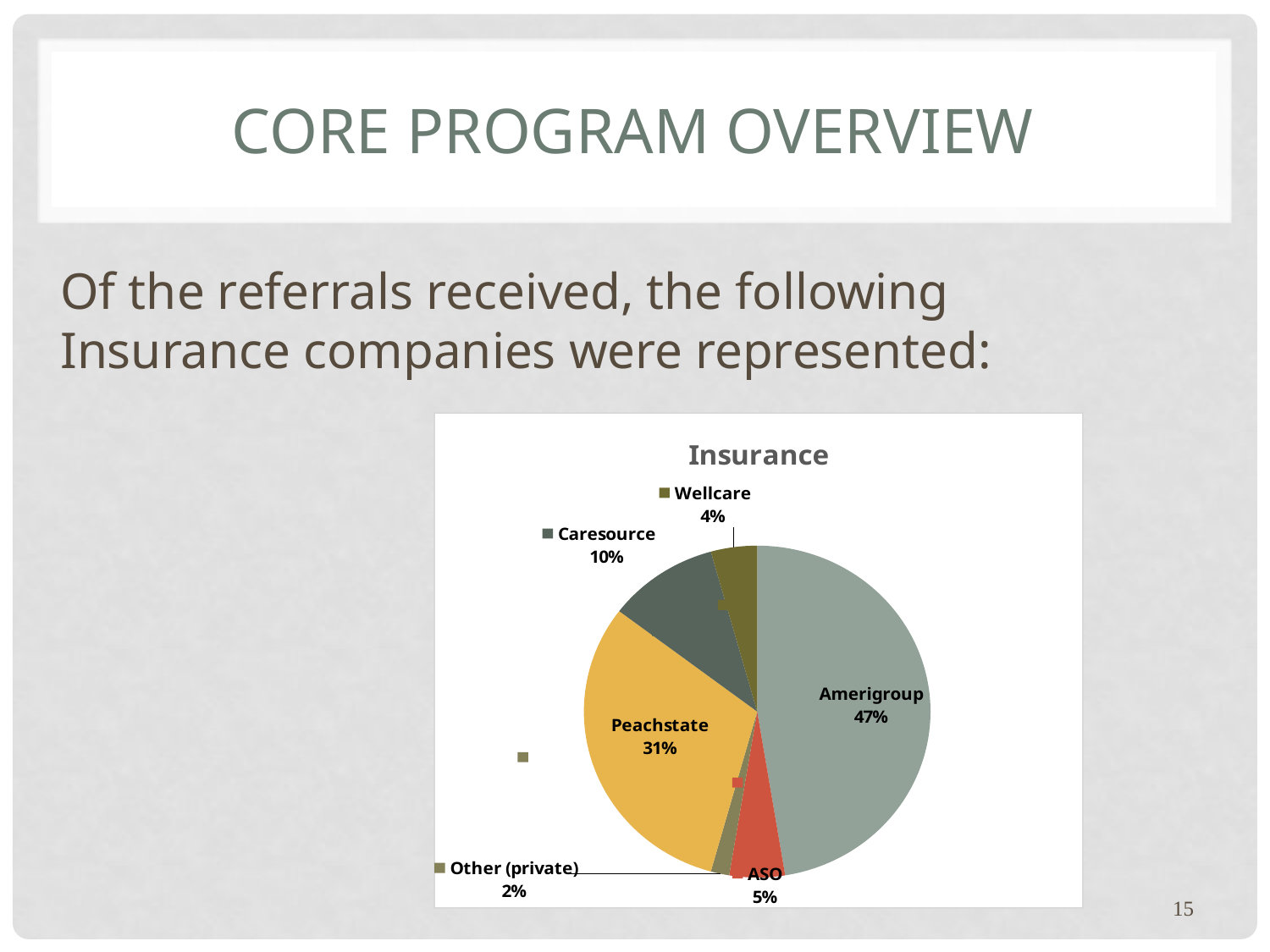
What is the value shown for ASO? 5% How many slices does the pie chart have? 6 Which is larger, the share for Caresource or the share for ASO? Caresource What is the title of the chart? Insurance What is the value shown for Wellcare? 4% Which insurance company has the largest share of the pie? Amerigroup Which category has the smallest share of the pie? Other (private) What is the value shown for Caresource? 10% What is the difference in percentage points between Amerigroup and Peachstate? 16 What kind of chart is shown on the slide? pie chart What share of the pie does Amerigroup represent? 47% What is the value shown for Peachstate? 31%